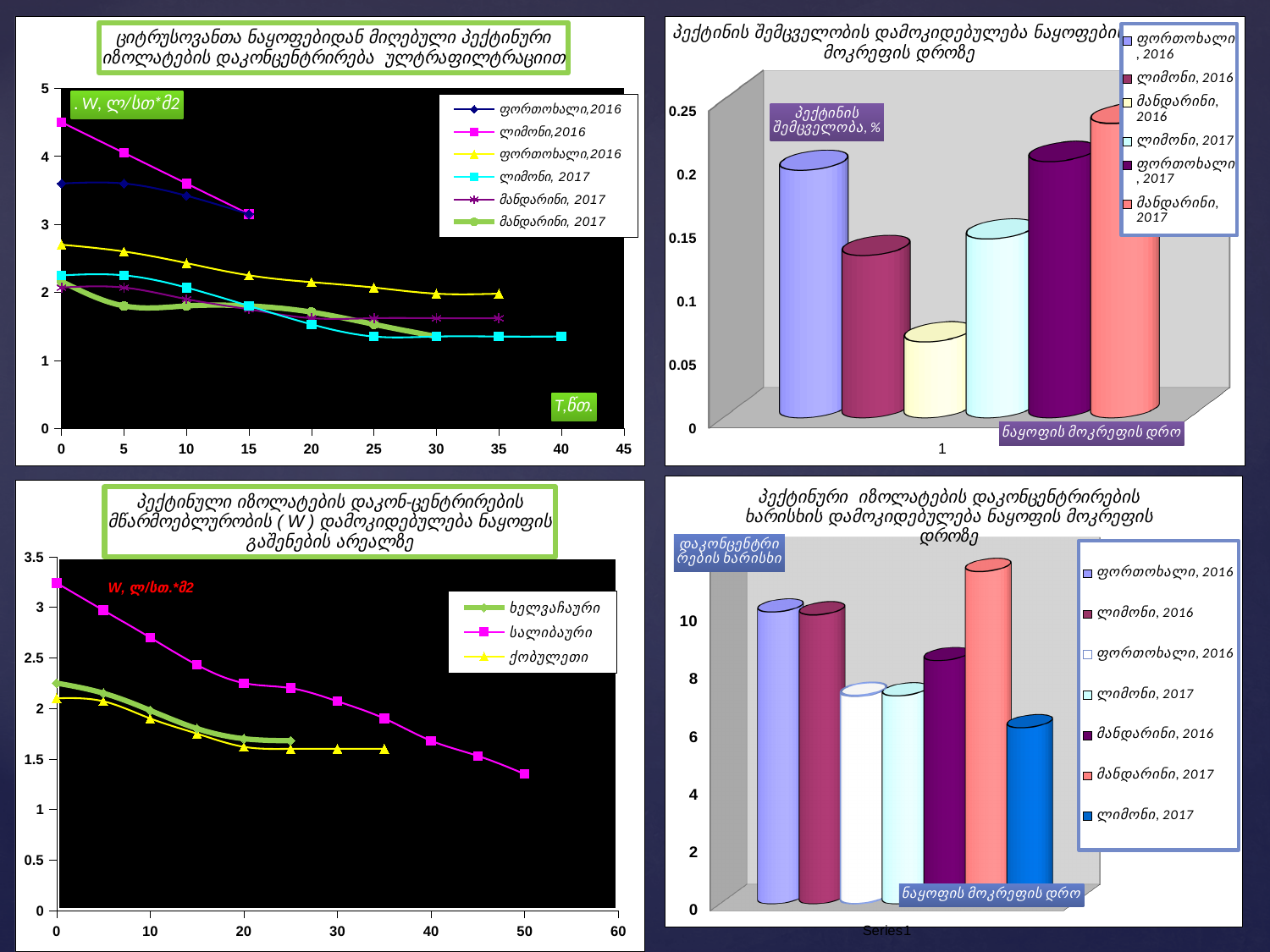
In the top-right chart, which series has the lowest bar? მანდარინი, 2016 In the bottom-right chart, is the value for მანდარინი, 2017 greater or less than 10? greater In the top-left chart, do the values of the ლიმონი,2016 series rise or fall along the x axis? fall How many series does the legend of the top-left chart list? 6 What kind of chart is the top-right chart titled "პექტინის შემცველობის დამოკიდებულება ნაყოფის მოკრეფის დროზე"? bar chart In the top-right chart, which series has the highest bar? მანდარინი, 2017 In the top-right chart, which is larger: the bar for ფორთოხალი, 2016 or the bar for ლიმონი, 2016? ფორთოხალი, 2016 In the top-right chart, is the value for ფორთოხალი, 2016 greater or less than 0.15? greater What kind of chart is the top-left chart titled "ციტრუსოვანთა ნაყოფებიდან მიღებული პექტინური იზოლატების დაკონცენტრირება ულტრაფილტრაციით"? line chart How many series does the legend of the bottom-left chart list? 3 In the bottom-right chart titled "პექტინური იზოლატების დაკონცენტრირების ხარისხის დამოკიდებულება ნაყოფის მოკრეფის დროზე", which series has the highest bar? მანდარინი, 2017 In the bottom-left chart, do the values of the სალიბაური series rise or fall along the x axis? fall